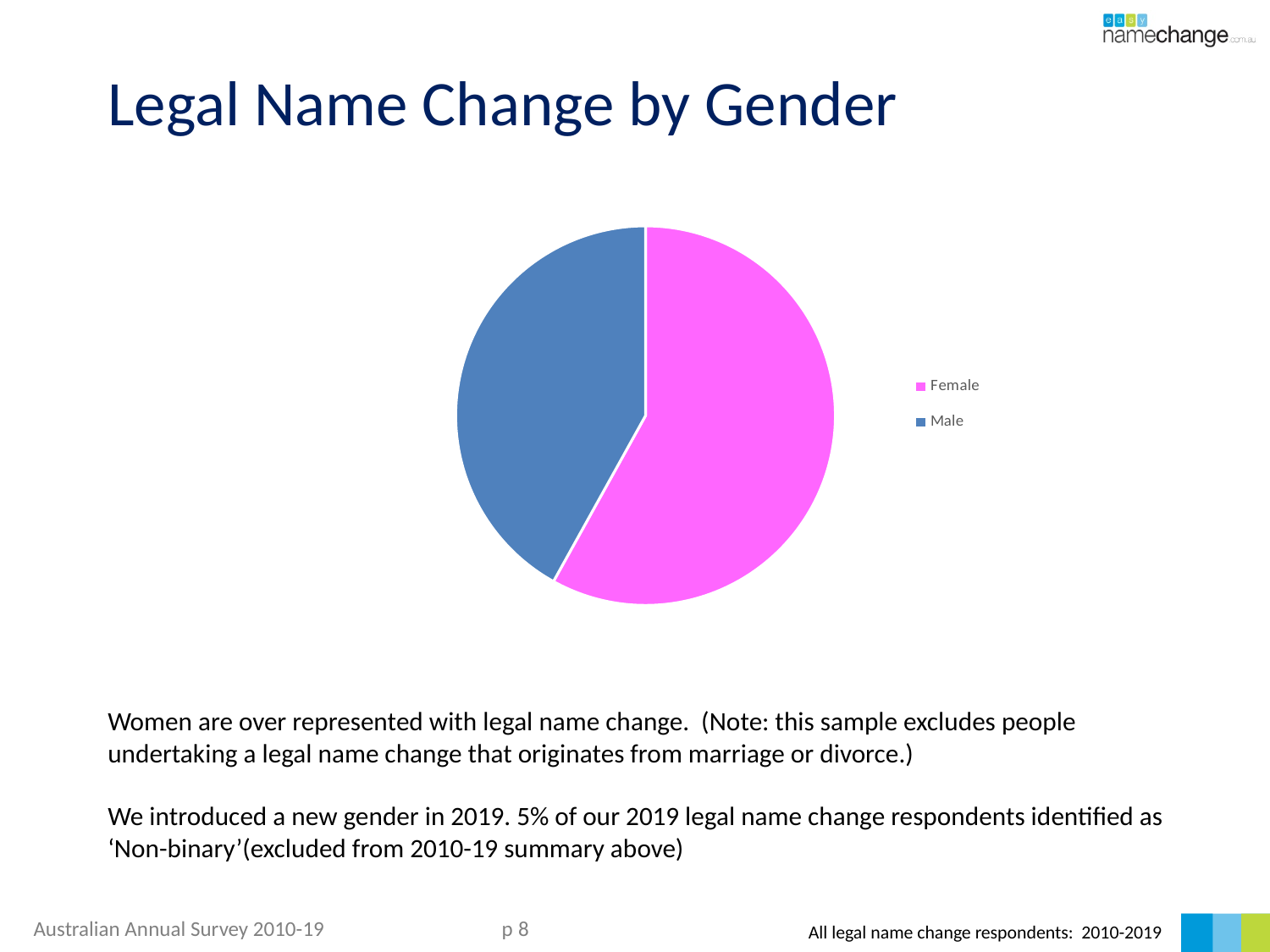
What colour is the Female slice in the pie chart? pink Which slice is larger in the pie chart, Female or Male? Female What are the two categories listed in the pie chart's legend? Female and Male How many entries does the legend of the pie chart list? 2 How many slices does the pie chart have? 2 Which gender has the smallest slice in the pie chart? Male What kind of chart is shown on the slide? pie chart Is the Female slice more or less than half of the pie chart? more Which gender has the largest slice in the pie chart? Female What colour is the Male slice in the pie chart? blue